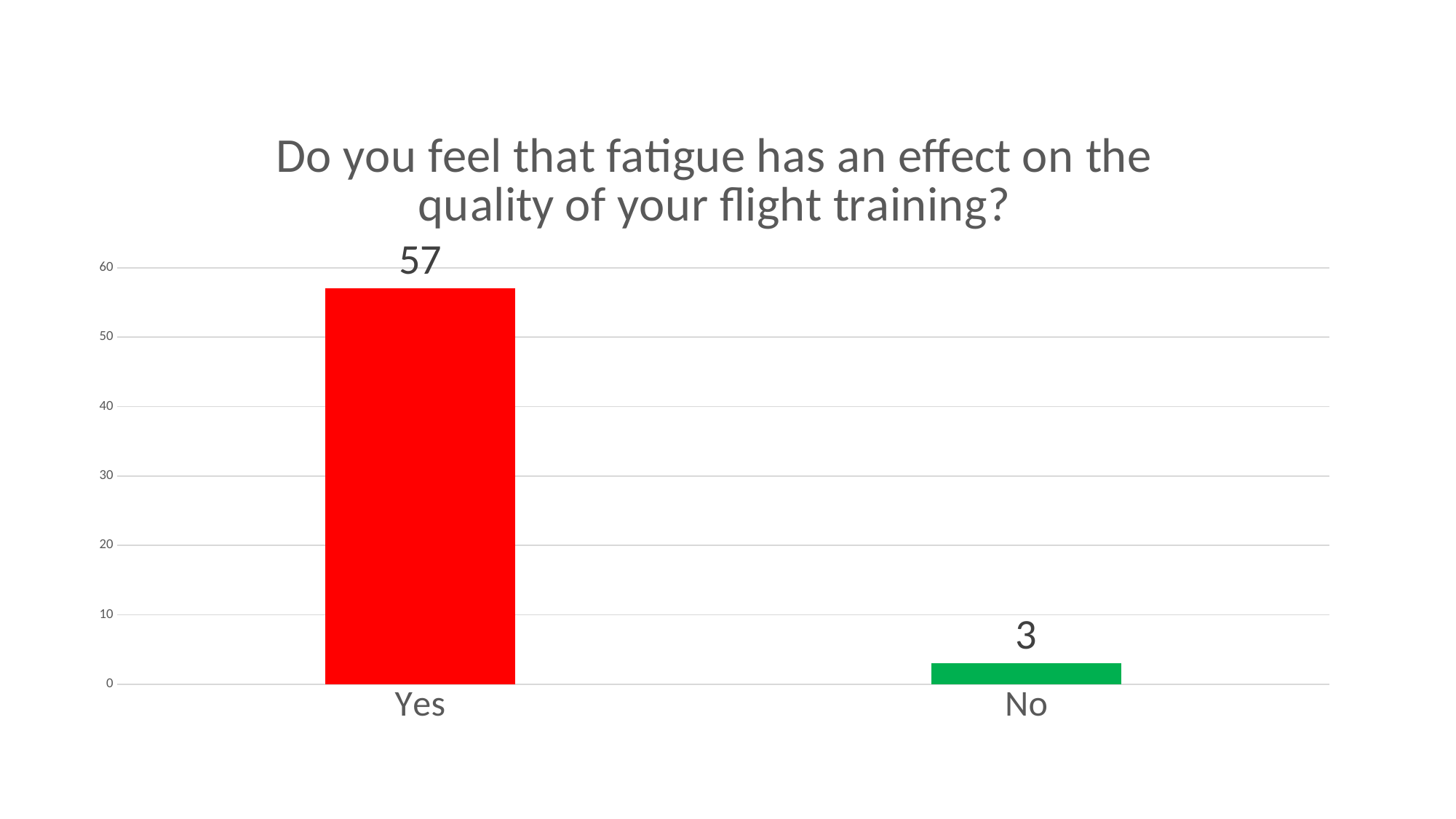
Which category has the lowest value? No What kind of chart is shown on the slide? bar chart Which is larger, the value for Yes or the value for No? Yes What colour is the bar for Yes? red What is the value for No? 3 What is the value for Yes? 57 How many categories are shown on the chart? 2 What is the difference between the values for Yes and No? 54 Is the value for No greater or less than 10? less What is the title of the chart? Do you feel that fatigue has an effect on the quality of your flight training? Which category has the highest value? Yes Is the value for Yes greater or less than 50? greater